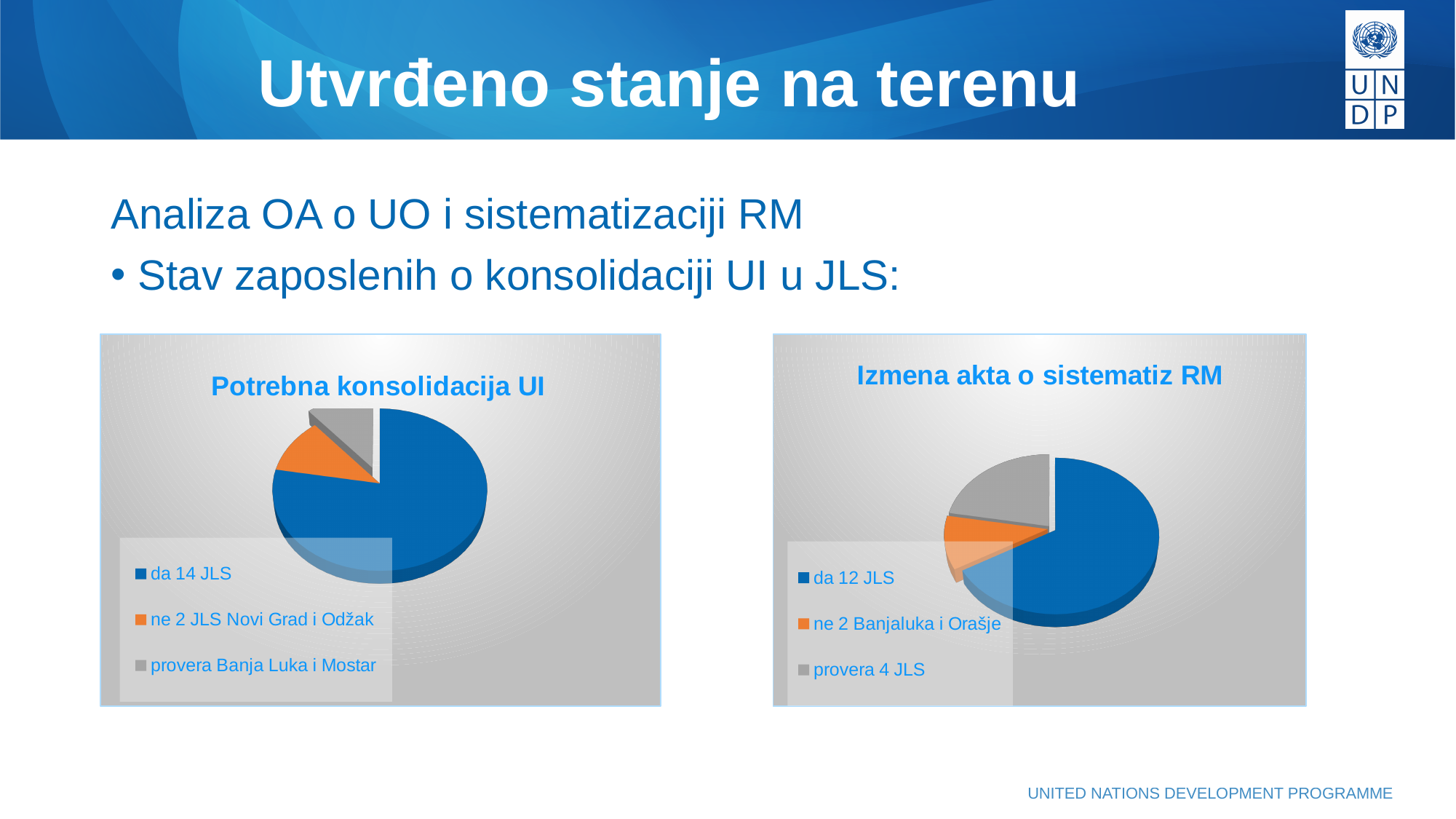
What kind of chart is the right chart titled "Izmena akta o sistematiz RM"? pie chart In the right chart "Izmena akta o sistematiz RM", how many JLS answered "da"? 12 JLS What kind of chart is the left chart titled "Potrebna konsolidacija UI"? pie chart How many categories does the legend of the left chart "Potrebna konsolidacija UI" list? 3 In the left chart "Potrebna konsolidacija UI", which category has the largest slice? da In the right chart "Izmena akta o sistematiz RM", what is the difference between the number of JLS answering "da" and those answering "ne"? 10 In the right chart "Izmena akta o sistematiz RM", which is larger: the "provera" slice or the "ne" slice? provera In the right chart "Izmena akta o sistematiz RM", how many JLS are in the "provera" category? 4 JLS In the left chart "Potrebna konsolidacija UI", how many JLS answered "da"? 14 JLS In the right chart "Izmena akta o sistematiz RM", what is the total number of JLS across all three categories? 18 In the right chart "Izmena akta o sistematiz RM", which category has the smallest slice? ne In the left chart "Potrebna konsolidacija UI", which two JLS are named in the "ne" legend entry? Novi Grad i Odžak